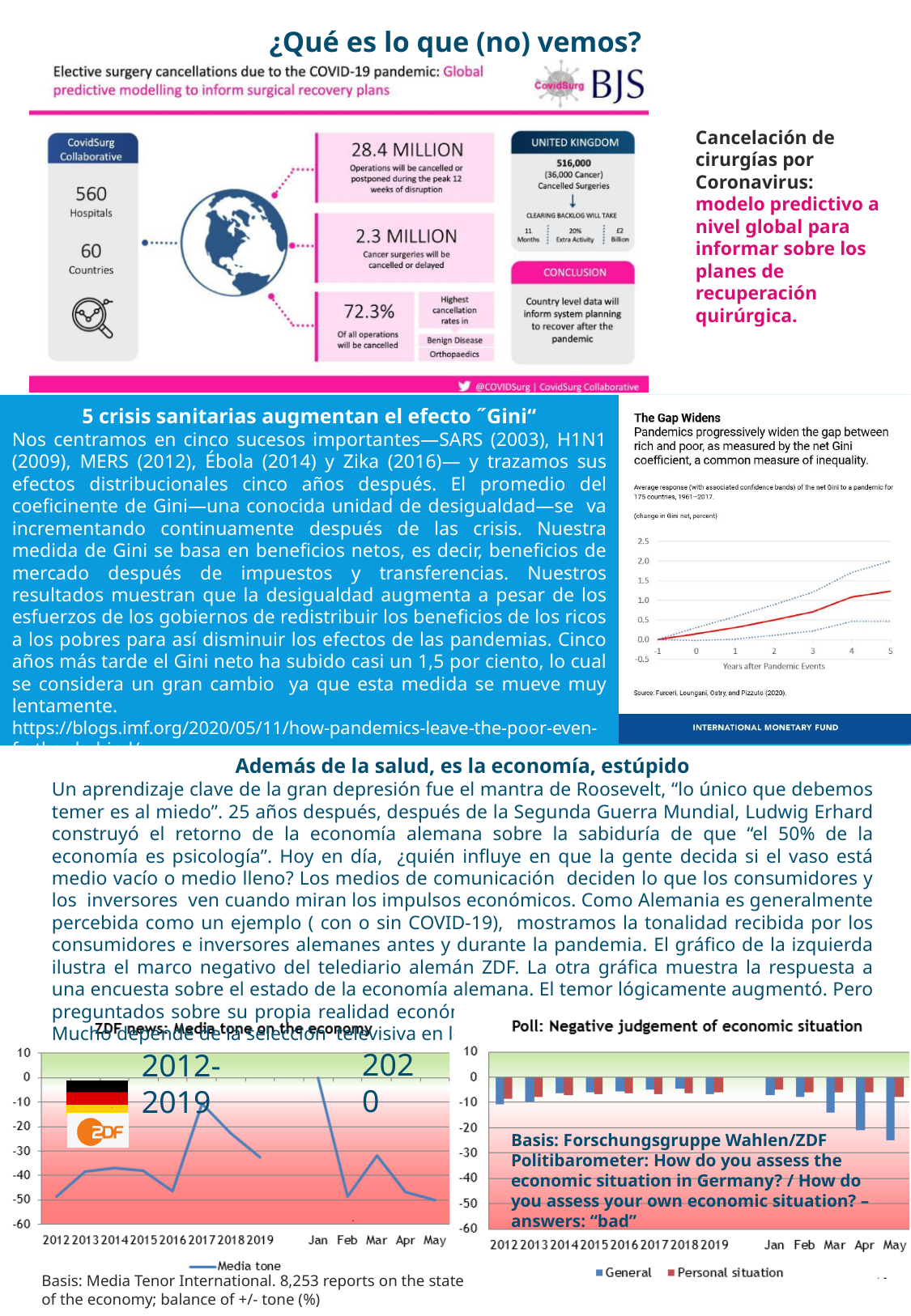
How many series does the legend of the 'Poll: Negative judgement of economic situation' chart list? 2 What kind of chart is the 'ZDF news: Media tone on the economy' chart? line chart In the 'Poll: Negative judgement of economic situation' chart, which month of 2020 has the lowest General value? Apr What is the x-axis label of the IMF 'The Gap Widens' chart? Years after Pandemic Events In the 'Poll: Negative judgement of economic situation' chart, is the General value for Apr greater or less than -20? less What are the two series named in the legend of the 'Poll: Negative judgement of economic situation' chart? General and Personal situation In the 'ZDF news: Media tone on the economy' chart, is the media tone value for 2012 greater or less than -40? less In the 'ZDF news: Media tone on the economy' chart, is the media tone value for 2017 greater or less than -20? greater In the IMF 'The Gap Widens' chart, does the red line for the net Gini coefficient rise or fall as the years after pandemic events increase? rise What kind of chart is the 'Poll: Negative judgement of economic situation' chart? bar chart In the 'ZDF news: Media tone on the economy' chart, how many months of 2020 are shown on the x axis? 5